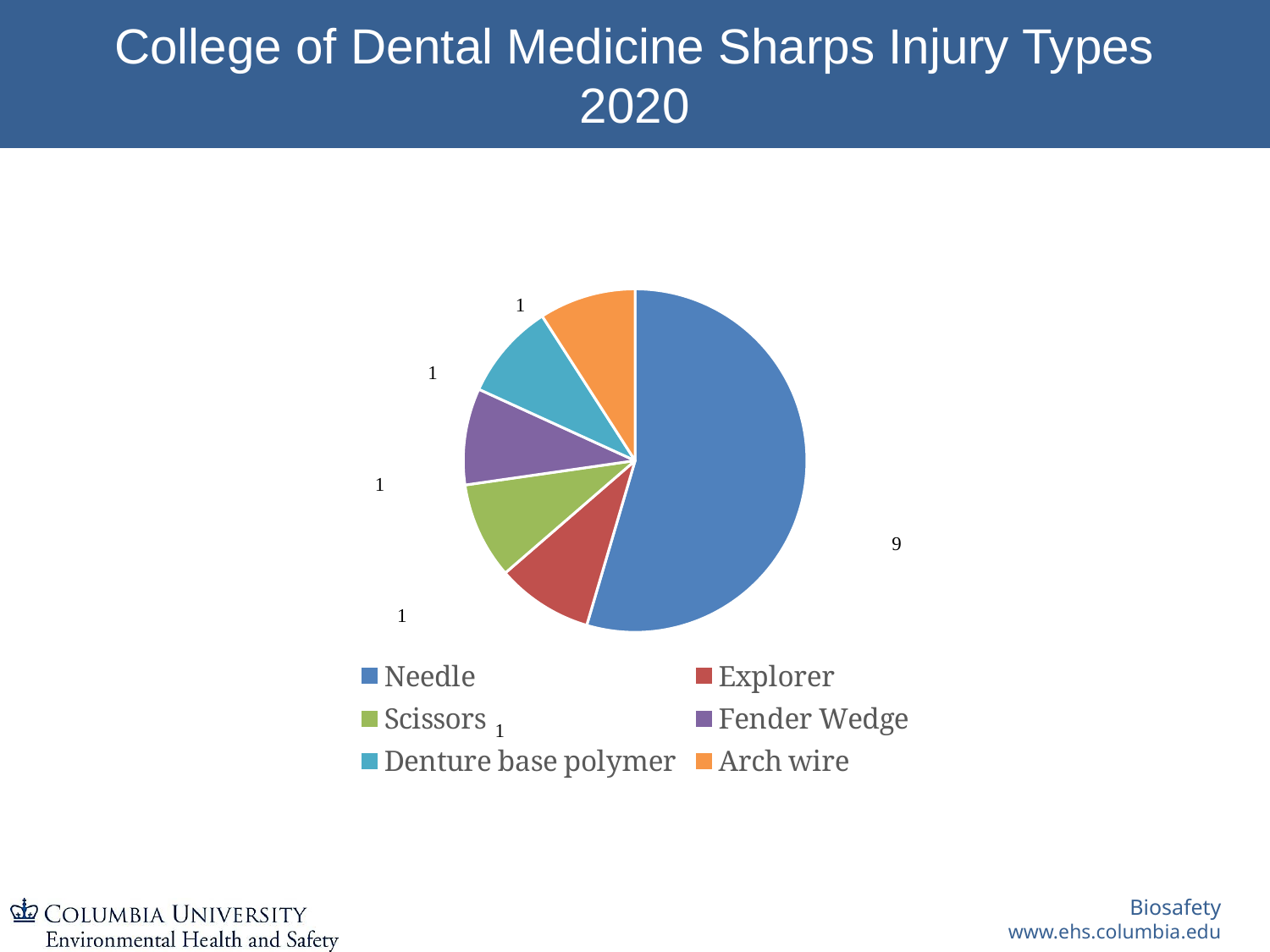
What is the value shown for Fender Wedge? 1 What is the total number of injuries across all slices of the pie chart? 14 Which is larger, the value for Needle or the value for Explorer? Needle How many injuries are attributed to Needle in the pie chart? 9 What is the title of the slide containing the pie chart? College of Dental Medicine Sharps Injury Types 2020 Which injury type has the largest slice of the pie? Needle What type of chart is shown on the slide? pie chart What is the value shown for Arch wire? 1 What is the difference between the Needle value and the Scissors value? 8 Which injury type is represented by the orange slice? Arch wire What is the value shown for Denture base polymer? 1 How many injury types (slices) are shown in the pie chart? 6